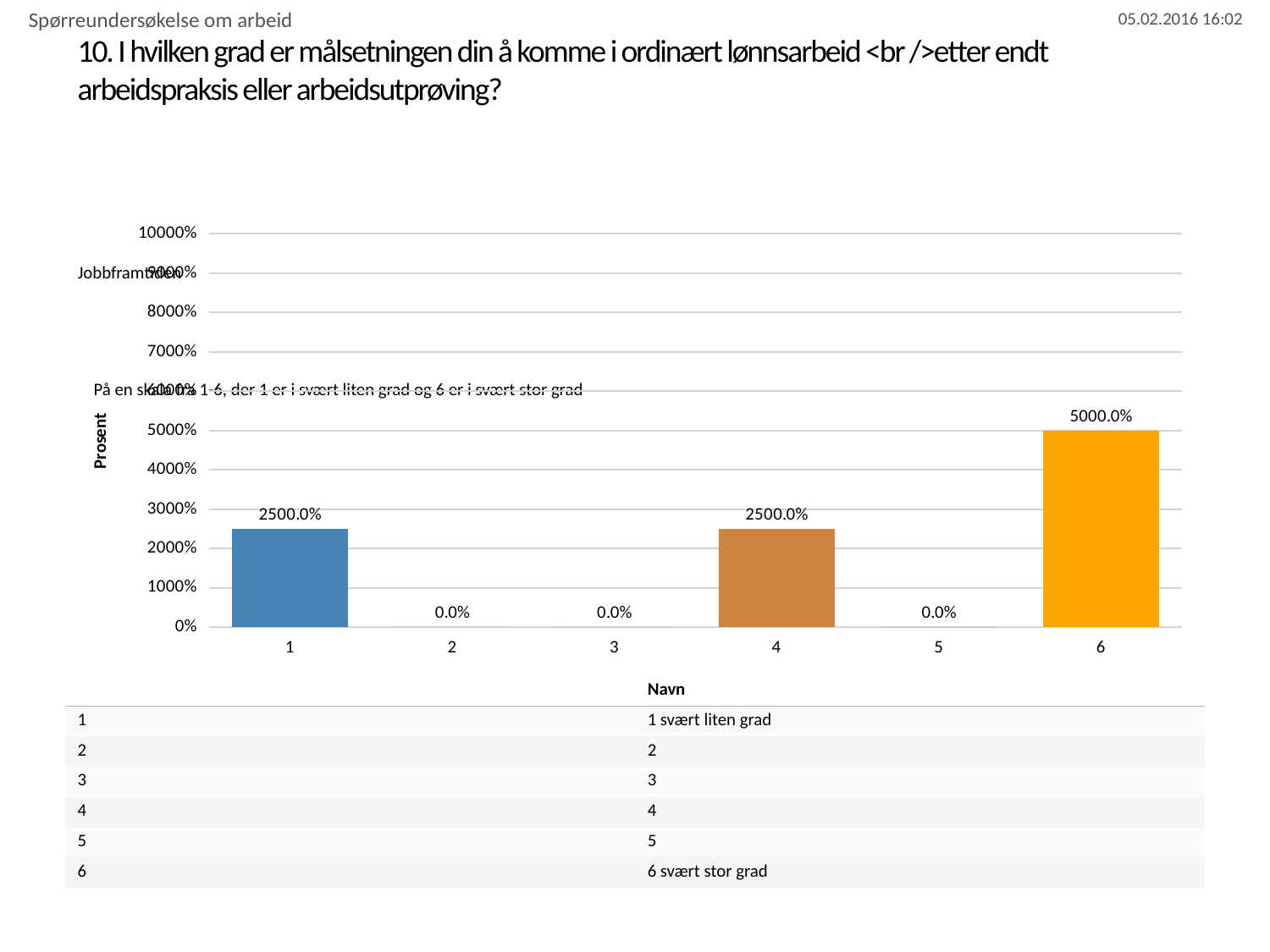
What is the value for category 6? 5000.0% Is the value for category 6 greater or less than 4000%? greater What is the difference between the values for category 6 and category 1? 2500.0% What is the value for category 1? 2500.0% What is the value for category 4? 2500.0% What is the value for category 2? 0.0% Which category has the highest value? 6 What is the label of the y axis? Prosent Which is larger, the value for category 4 or the value for category 6? 6 How many categories are shown on the x axis? 6 What kind of chart is shown? bar chart How many categories have a value of 0.0%? 3